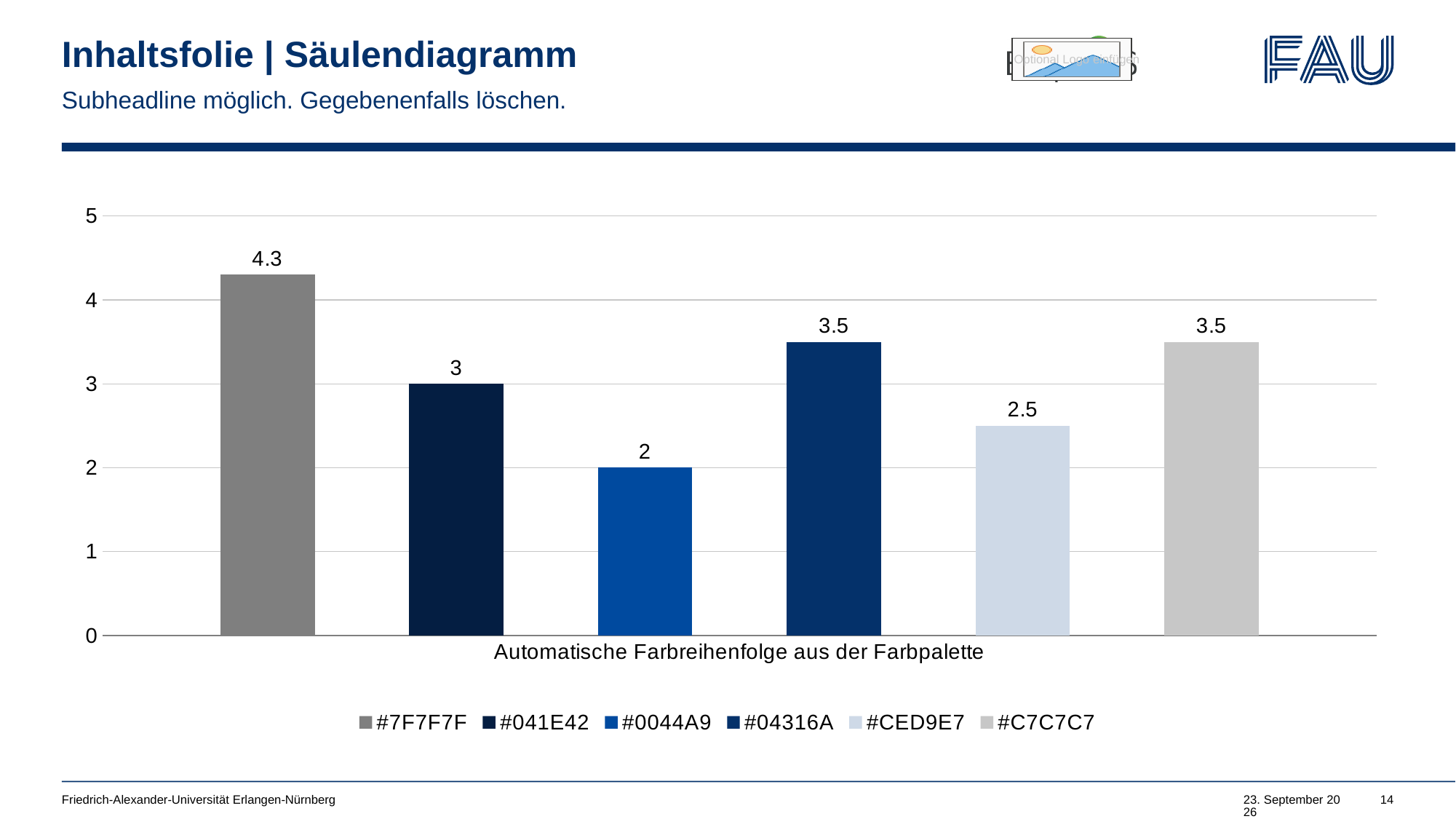
What is the value for the #0044A9 series? 2 Which series has the highest value? #7F7F7F What is the value for the #CED9E7 series? 2.5 What kind of chart is shown on the slide? Bar chart What is the value for the #041E42 series? 3 Which series has the lowest value? #0044A9 What is the highest value shown on the y axis? 5 How many series does the legend list? 6 Which is larger, the value for #04316A or the value for #CED9E7? #04316A What is the category label shown on the x axis? Automatische Farbreihenfolge aus der Farbpalette What is the difference between the values for #7F7F7F and #041E42? 1.3 What is the value for the #7F7F7F series? 4.3